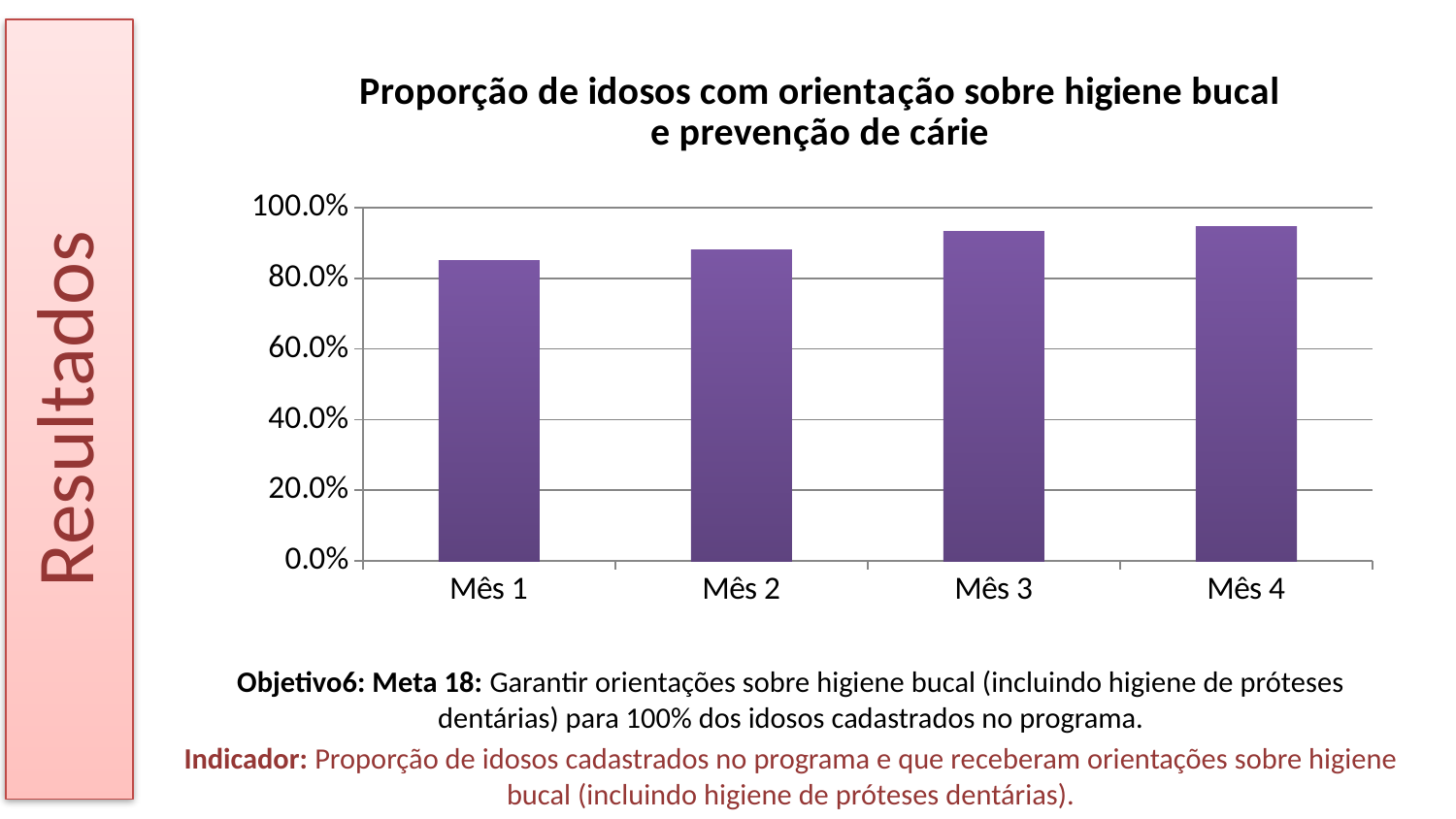
What is the title of the chart? Proporção de idosos com orientação sobre higiene bucal e prevenção de cárie Do the values rise or fall from Mês 1 to Mês 4? rise Which is larger, the value for Mês 1 or the value for Mês 3? Mês 3 How many months (categories) are plotted on the x axis? 4 What is the highest tick value shown on the y axis? 100.0% Is the value for Mês 3 greater or less than 80.0%? greater Which month has the lowest value? Mês 1 Which is larger, the value for Mês 2 or the value for Mês 4? Mês 4 Is the value for Mês 1 greater or less than 80.0%? greater Is the value for Mês 4 greater or less than 100.0%? less What kind of chart is shown on the slide? bar chart